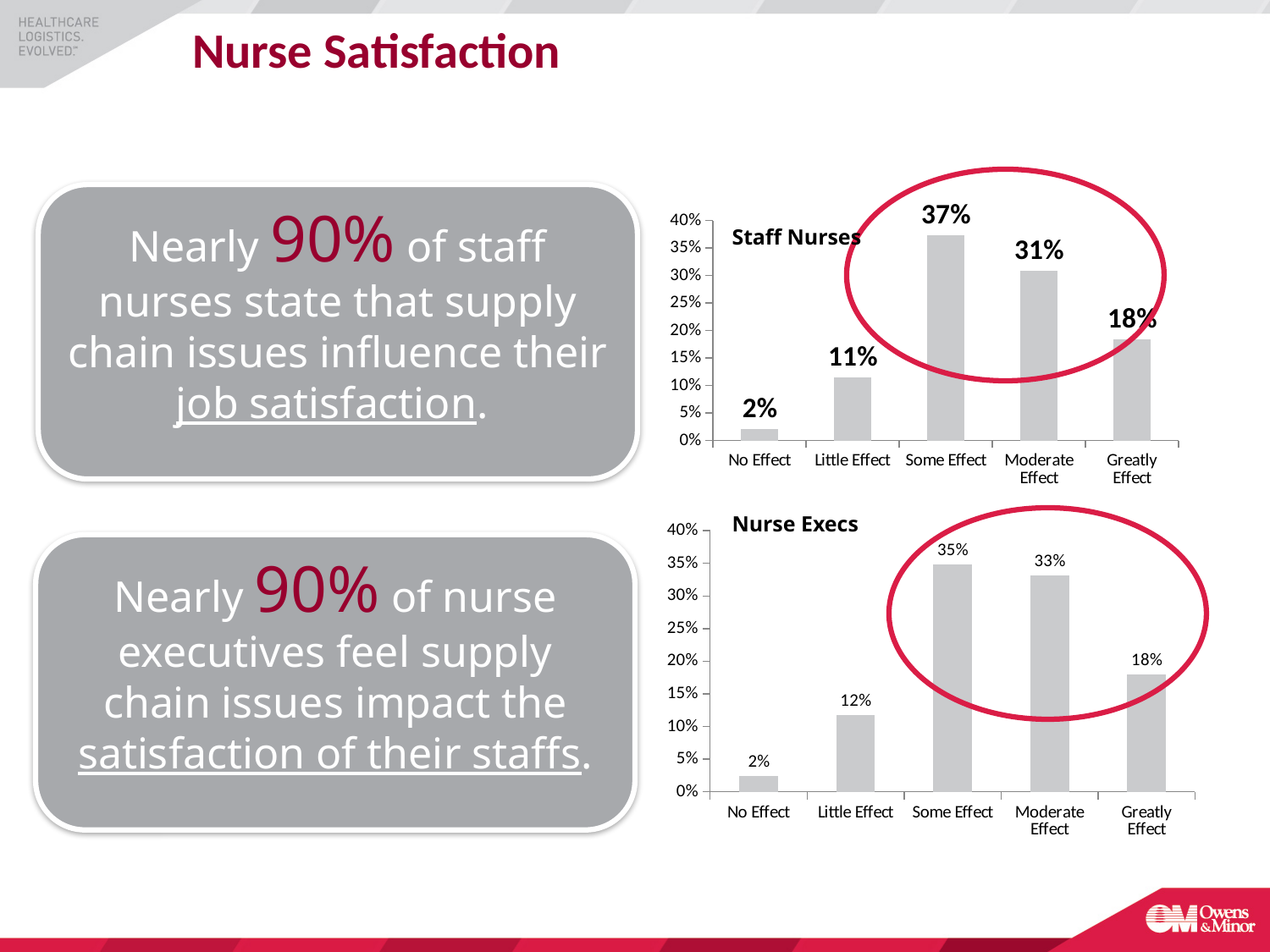
In the Staff Nurses chart, which category has the highest value? Some Effect What kind of chart is the Staff Nurses chart? Bar chart In the Staff Nurses chart, what is the value for No Effect? 2% How many categories are shown in the Nurse Execs chart? 5 In the Nurse Execs chart, which category has the lowest value? No Effect In the Nurse Execs chart, what is the difference between Some Effect and Greatly Effect? 17% In the Staff Nurses chart, which is larger, Little Effect or Greatly Effect? Greatly Effect In the Nurse Execs chart, what is the value for Moderate Effect? 33% In the Staff Nurses chart, what is the value for Some Effect? 37% In the Staff Nurses chart, what is the difference between Some Effect and Moderate Effect? 6% What is the title of the lower chart on the slide? Nurse Execs In the Nurse Execs chart, what is the value for Little Effect? 12%